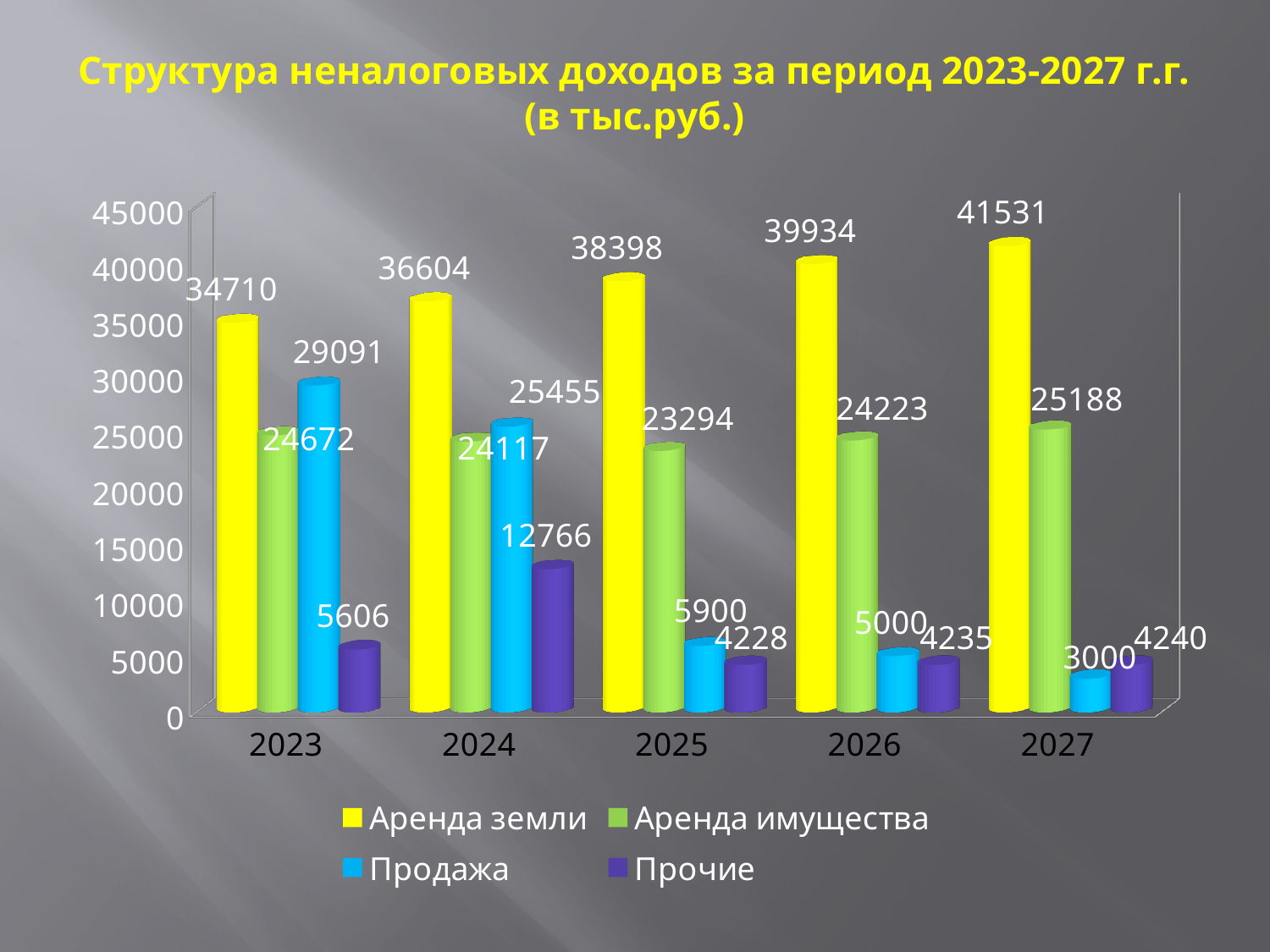
What is the value for Аренда земли in 2025? 38398 In which year is the value for Продажа the lowest? 2027 How many series does the legend list? 4 What kind of chart is shown on the slide? bar chart What is the value for Продажа in 2023? 29091 Is the value for Аренда земли in 2026 greater or less than 35000? greater Which is larger in 2023: Аренда имущества or Продажа? Продажа What is the difference between Аренда земли in 2027 and in 2023? 6821 What is the value for Прочие in 2024? 12766 How many years are shown on the x axis? 5 Does the value for Аренда земли rise or fall from 2023 to 2027? rise In which year is the value for Аренда земли the highest? 2027